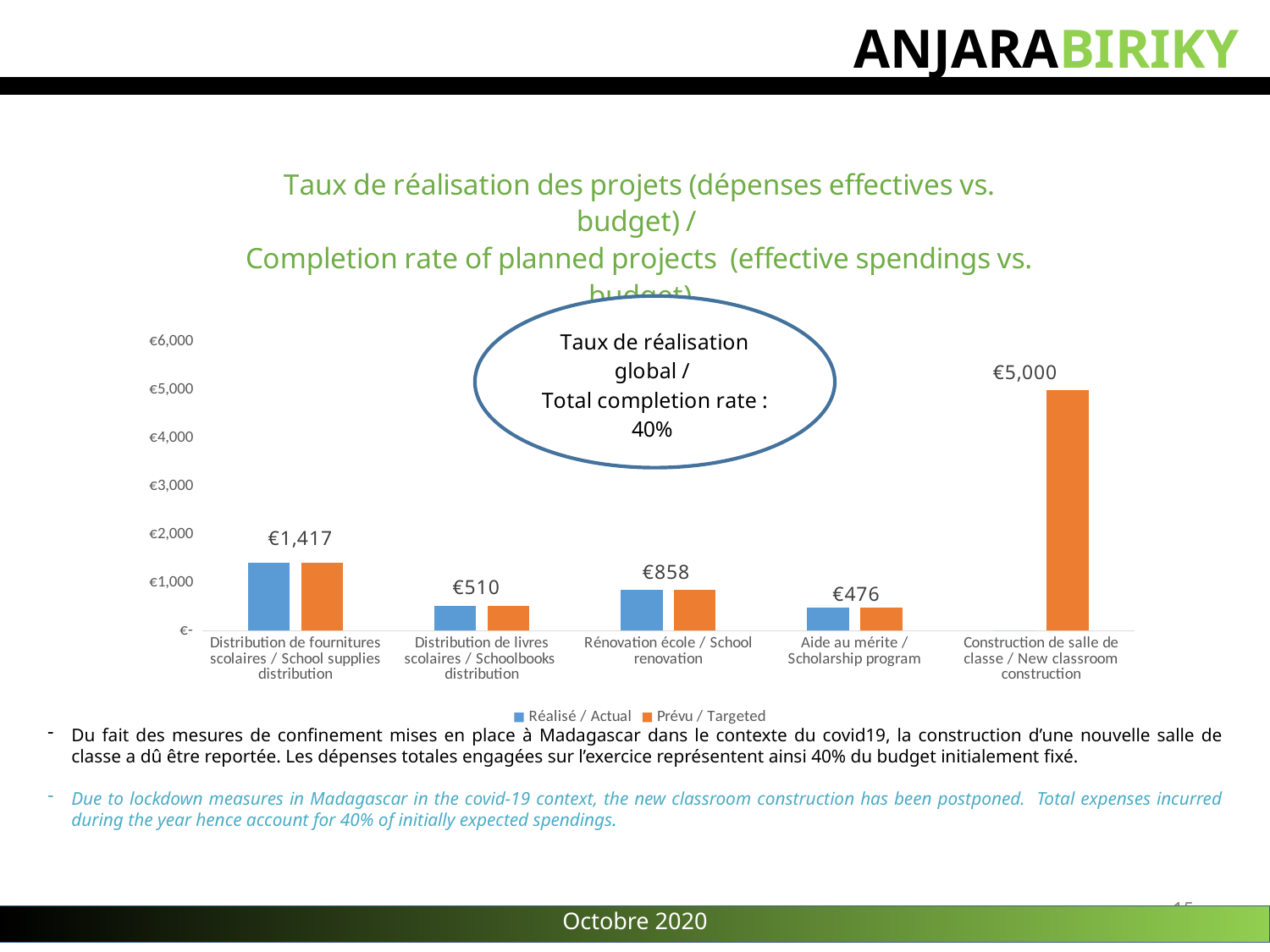
What total completion rate is stated in the callout on the chart? 40% Is the Réalisé / Actual value for Construction de salle de classe / New classroom construction greater or less than €1,000? less What is the Prévu / Targeted value for Construction de salle de classe / New classroom construction? €5,000 How many project categories are shown on the x axis of the chart? 5 Which category has the highest Prévu / Targeted value? Construction de salle de classe / New classroom construction What kind of chart is shown on the slide? Bar chart What is the difference between the Prévu / Targeted values for New classroom construction and School supplies distribution? €3,583 What is the Prévu / Targeted value for Distribution de fournitures scolaires / School supplies distribution? €1,417 Which has the larger Prévu / Targeted value: School renovation or Schoolbooks distribution? Rénovation école / School renovation What colour represents the Prévu / Targeted series in the chart? Orange How many series does the chart legend list? 2 Which category has the lowest Prévu / Targeted value? Aide au mérite / Scholarship program